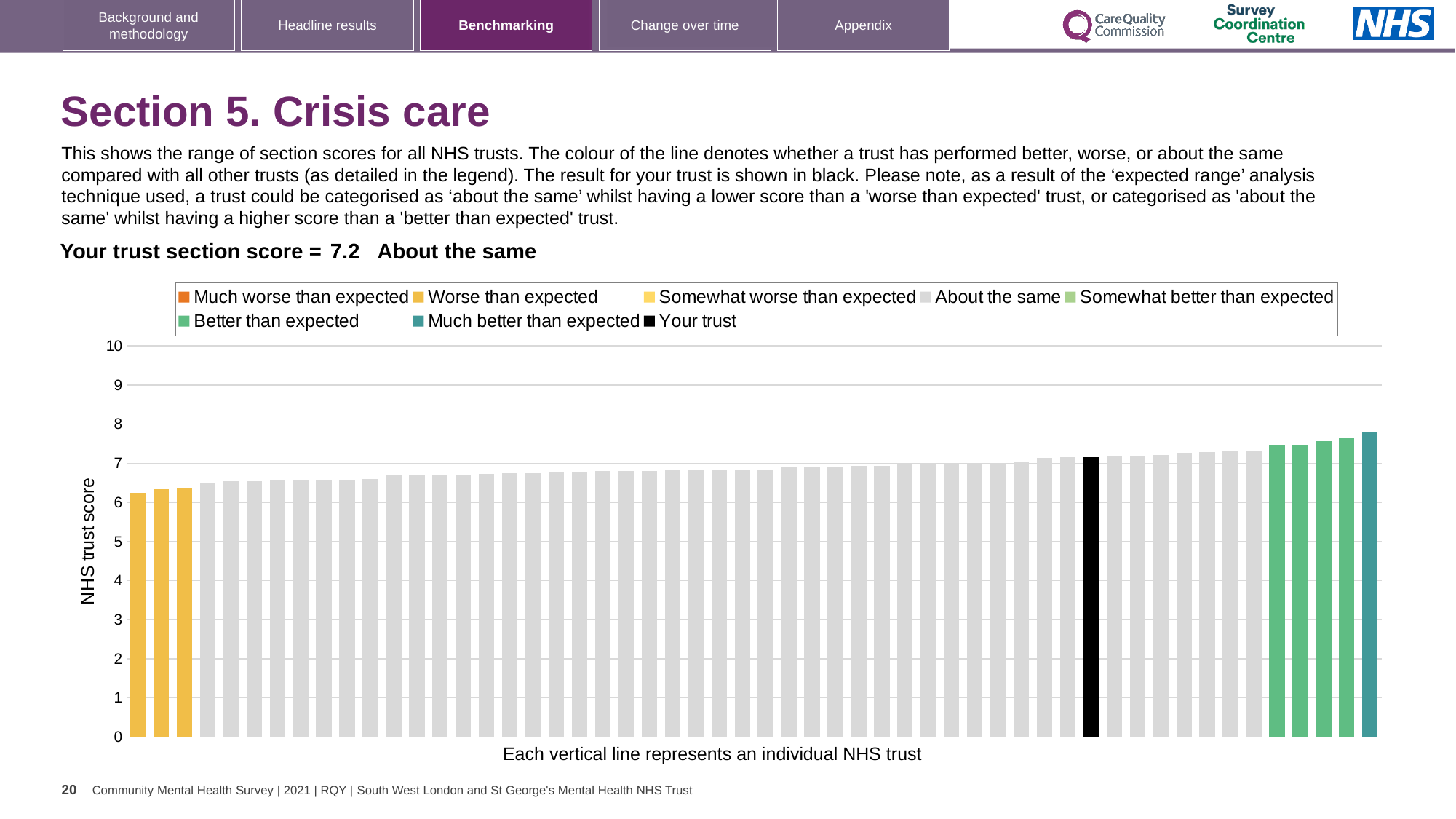
What is the section score for your trust shown on the slide? 7.2 Is the value of the rightmost bar greater or less than 7? greater Do the bar values rise or fall from left to right along the x axis? rise Is the black bar for your trust higher or lower than the leftmost bar? higher Which category is your trust's section score placed in? About the same How many bars are coloured as 'Worse than expected'? 3 Is the value of the leftmost bar greater or less than 7? less What kind of chart is shown on the slide? bar chart How many entries does the chart legend list? 8 What is the title of the vertical axis? NHS trust score How many bars are coloured as 'Better than expected'? 4 Is the value of the black bar (your trust) greater or less than 8? less